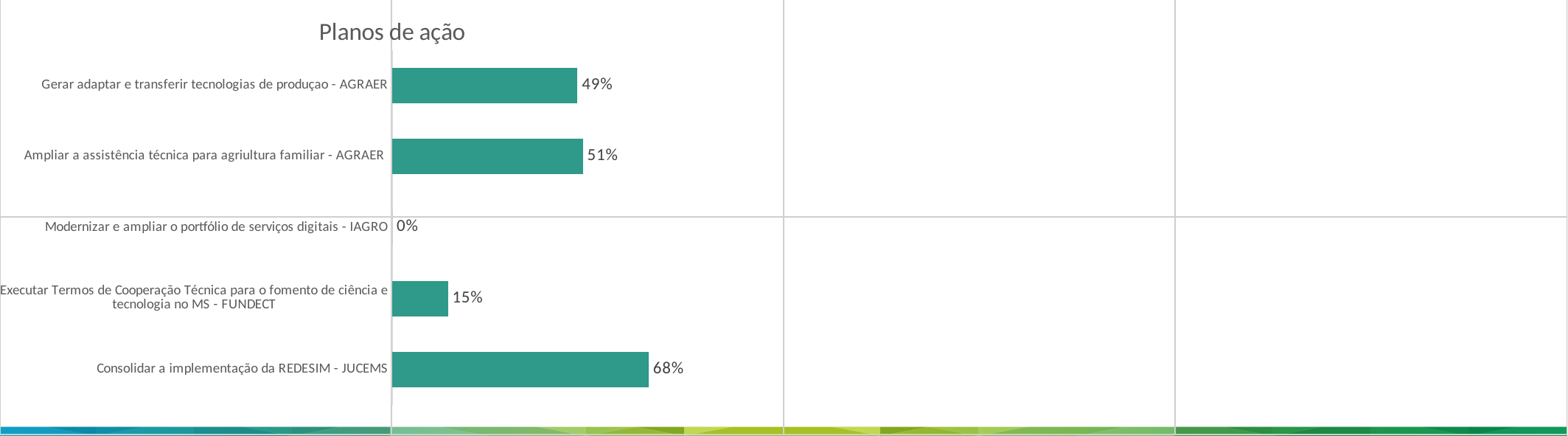
What is the value for 'Modernizar e ampliar o portfólio de serviços digitais - IAGRO'? 0% Which category has the highest value? Consolidar a implementação da REDESIM - JUCEMS Which category has the lowest value? Modernizar e ampliar o portfólio de serviços digitais - IAGRO How many categories are shown in the chart? 5 What is the value for 'Executar Termos de Cooperação Técnica para o fomento de ciência e tecnologia no MS - FUNDECT'? 15% Which is larger: the value for 'Gerar adaptar e transferir tecnologias de produçao - AGRAER' or the value for 'Executar Termos de Cooperação Técnica para o fomento de ciência e tecnologia no MS - FUNDECT'? Gerar adaptar e transferir tecnologias de produçao - AGRAER What is the title of the chart? Planos de ação What is the value for 'Gerar adaptar e transferir tecnologias de produçao - AGRAER'? 49% What is the difference between the values for 'Ampliar a assistência técnica para agriultura familiar - AGRAER' and 'Gerar adaptar e transferir tecnologias de produçao - AGRAER'? 2% What is the difference between the values for 'Consolidar a implementação da REDESIM - JUCEMS' and 'Ampliar a assistência técnica para agriultura familiar - AGRAER'? 17% What kind of chart is shown on the slide? Bar chart What is the value for 'Consolidar a implementação da REDESIM - JUCEMS'? 68%